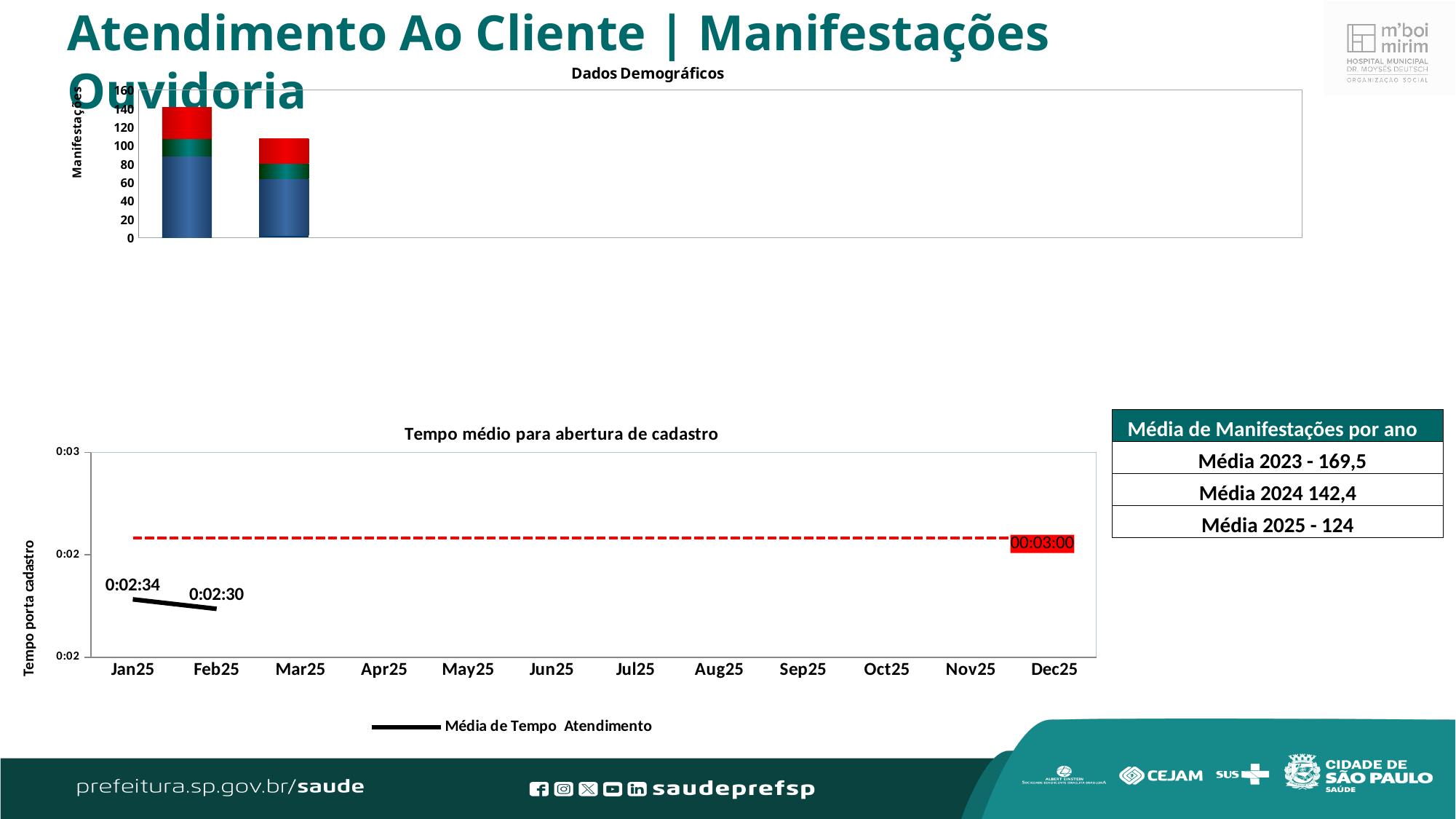
In the chart titled 'Dados Demográficos', is the total of the first (left) bar greater or less than 120? greater In the chart titled 'Dados Demográficos', how many bars are plotted? 2 In the chart titled 'Tempo médio para abertura de cadastro', how many months are shown on the x axis? 12 What kind of chart is 'Dados Demográficos' at the top of the slide? stacked bar chart In the chart titled 'Tempo médio para abertura de cadastro', by how many seconds does the value change from Jan25 to Feb25? 4 seconds In the chart titled 'Tempo médio para abertura de cadastro', what is the value for Jan25? 0:02:34 In the chart titled 'Tempo médio para abertura de cadastro', what is the value for Feb25? 0:02:30 In the chart titled 'Tempo médio para abertura de cadastro', what is the legend entry? Média de Tempo Atendimento In the chart titled 'Tempo médio para abertura de cadastro', what value is labelled on the red dashed line? 00:03:00 What kind of chart is 'Tempo médio para abertura de cadastro'? line chart In the chart titled 'Tempo médio para abertura de cadastro', which month has the larger value, Jan25 or Feb25? Jan25 In the chart titled 'Tempo médio para abertura de cadastro', does the line rise or fall from Jan25 to Feb25? fall